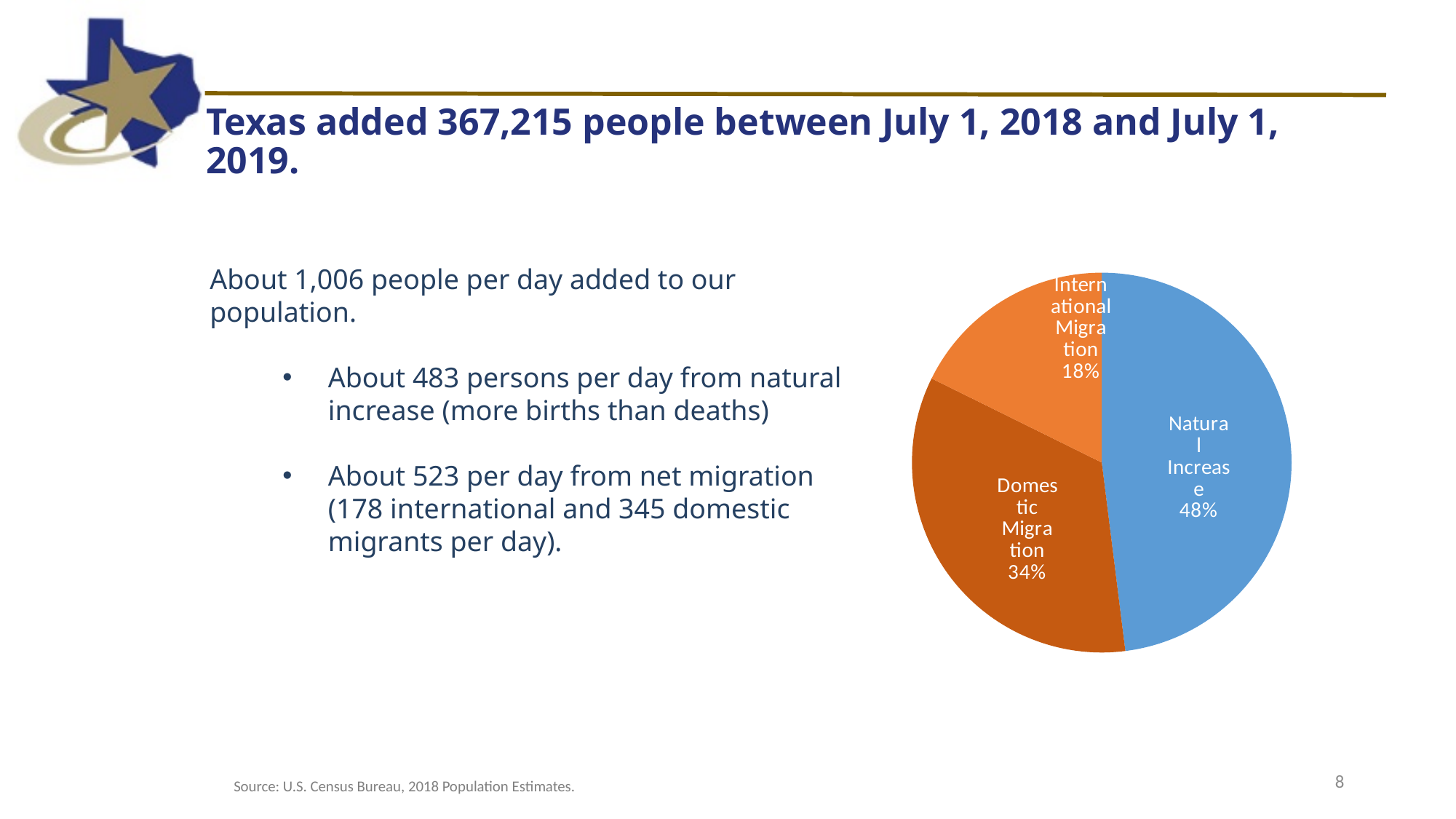
Which slice of the pie chart is the largest? Natural Increase What is the difference in percentage points between Domestic Migration and International Migration? 16 What colour is the Natural Increase slice of the pie chart? blue What share of the pie does Domestic Migration represent? 34% What is the combined share of Domestic Migration and International Migration? 52% Which is larger, the Domestic Migration slice or the International Migration slice? Domestic Migration What share of the pie does International Migration represent? 18% Which slice of the pie chart is the smallest? International Migration What kind of chart is shown on the slide? pie chart What is the difference in percentage points between Natural Increase and Domestic Migration? 14 How many slices does the pie chart have? 3 What share of the pie does Natural Increase represent? 48%